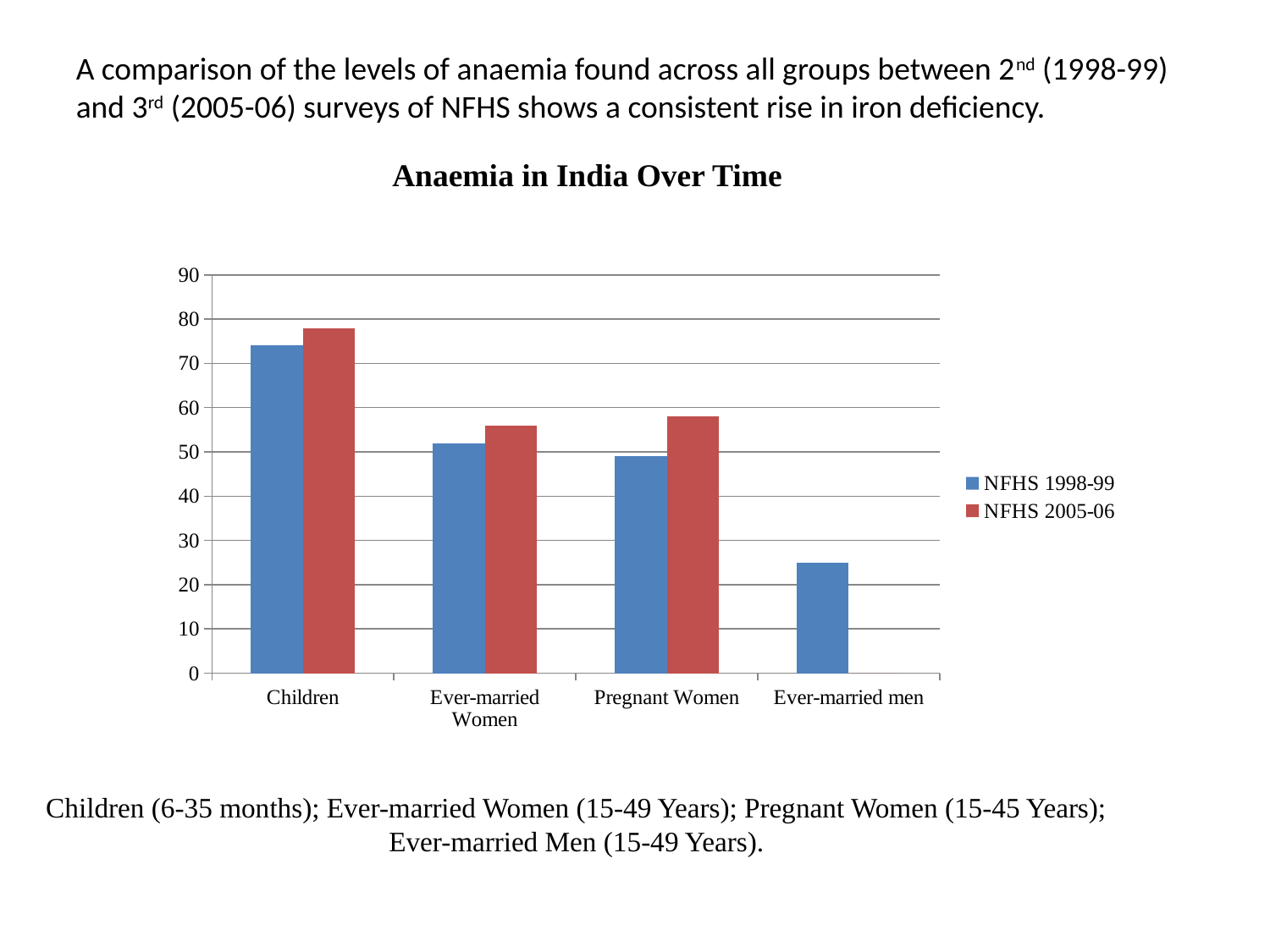
How many categories are shown on the x axis? 4 What kind of chart is shown on the slide? bar chart Which category has no bar for the NFHS 2005-06 series? Ever-married men Which category has the lowest value for NFHS 1998-99? Ever-married men Is the NFHS 1998-99 value for Ever-married men greater or less than 30? less Which category has the highest value for NFHS 2005-06? Children For Pregnant Women, which series has the larger value, NFHS 1998-99 or NFHS 2005-06? NFHS 2005-06 Is the NFHS 2005-06 value for Pregnant Women greater or less than 50? greater What is the title of the chart? Anaemia in India Over Time Which category has the highest value for NFHS 1998-99? Children Is the NFHS 1998-99 value for Children greater or less than 70? greater How many series does the legend list? 2